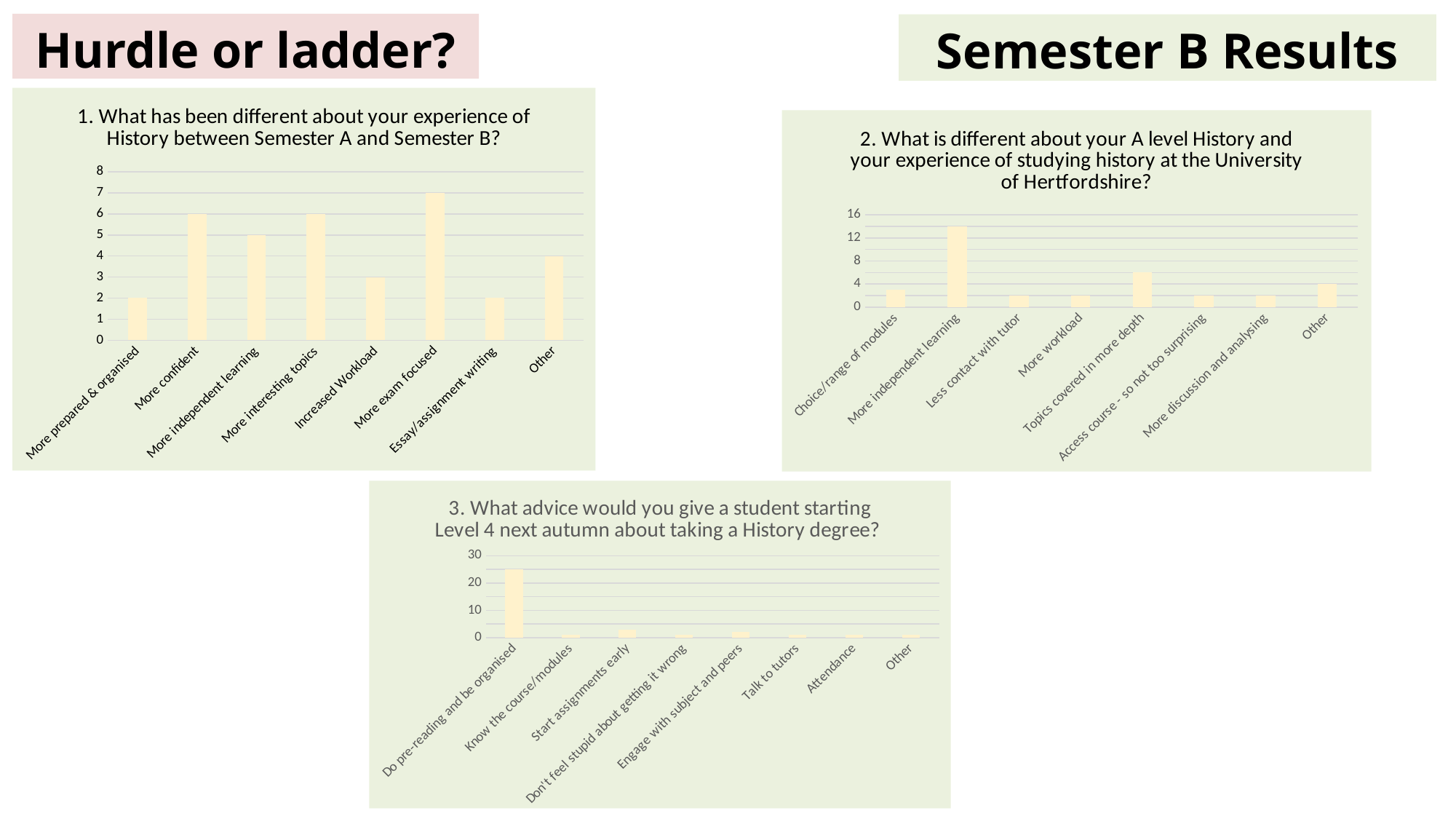
What kind of chart is the chart titled '3. What advice would you give a student starting Level 4 next autumn about taking a History degree?'? Bar chart In the chart titled '3. What advice would you give a student starting Level 4 next autumn about taking a History degree?', is the value for 'Do pre-reading and be organised' greater or less than 20? greater In the chart titled '1. What has been different about your experience of History between Semester A and Semester B?', which is larger: 'More independent learning' or 'Other'? More independent learning In the chart titled '1. What has been different about your experience of History between Semester A and Semester B?', which category has the highest value? More exam focused In the chart titled '2. What is different about your A level History and your experience of studying history at the University of Hertfordshire?', which category has the highest value? More independent learning In the chart titled '1. What has been different about your experience of History between Semester A and Semester B?', how many categories are shown on the x axis? 8 In the chart titled '2. What is different about your A level History and your experience of studying history at the University of Hertfordshire?', is the value for 'Topics covered in more depth' greater or less than 8? less In the chart titled '2. What is different about your A level History and your experience of studying history at the University of Hertfordshire?', is the value for 'More independent learning' greater or less than 12? greater In the chart titled '1. What has been different about your experience of History between Semester A and Semester B?', what is the difference between 'More confident' and 'More prepared & organised'? 4 In the chart titled '3. What advice would you give a student starting Level 4 next autumn about taking a History degree?', which category has the highest value? Do pre-reading and be organised In the chart titled '1. What has been different about your experience of History between Semester A and Semester B?', what is the value for 'Increased Workload'? 3 In the chart titled '1. What has been different about your experience of History between Semester A and Semester B?', what is the value for 'More exam focused'? 7